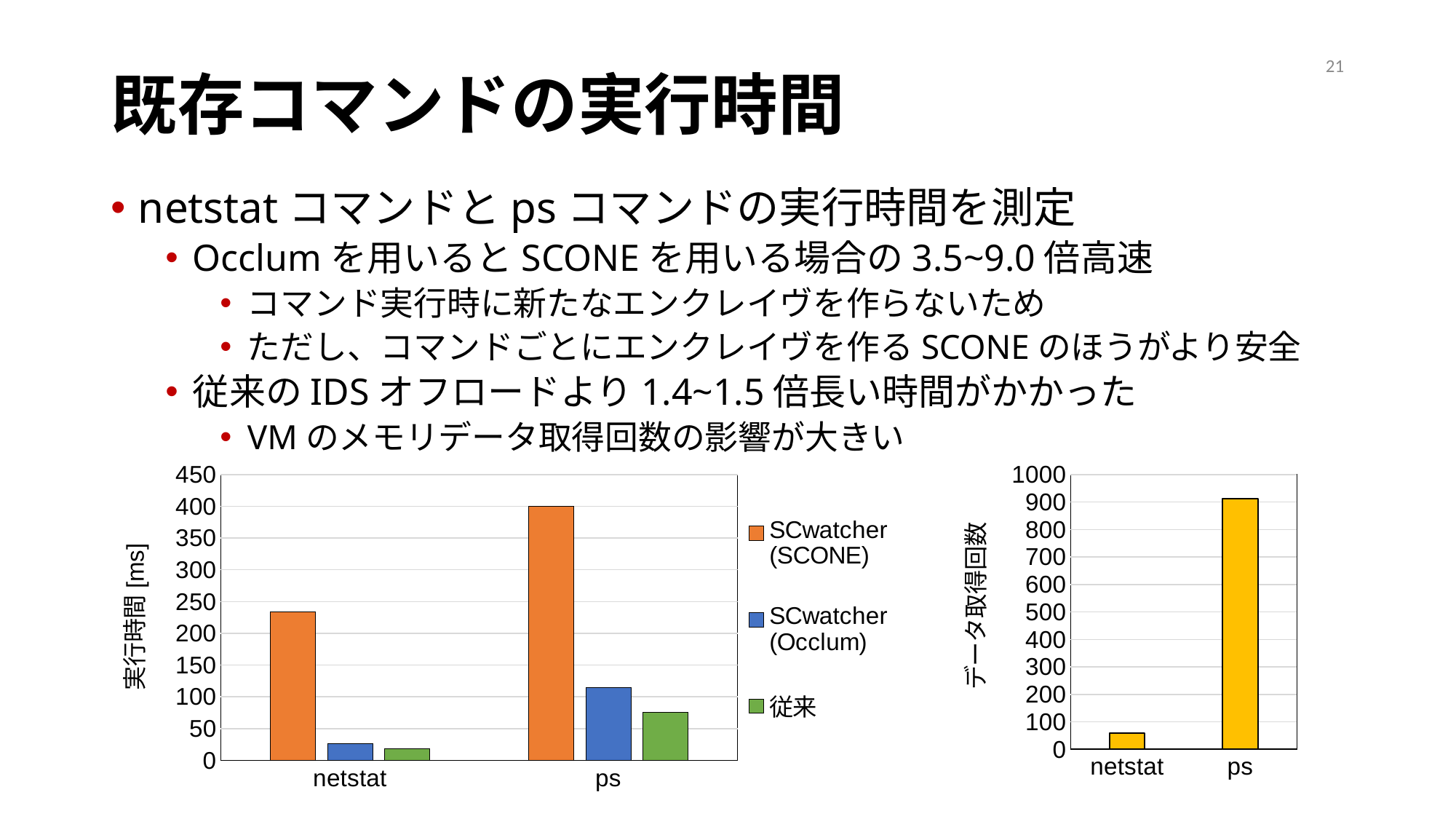
In the left chart (実行時間 [ms]), is the SCwatcher (Occlum) value for ps greater or less than 150? less In the right chart (データ取得回数), which category has the highest value? ps How many series does the legend of the left chart (実行時間 [ms]) list? 3 In the left chart (実行時間 [ms]), which series has the lowest value for netstat? 従来 In the left chart (実行時間 [ms]), does the SCwatcher (SCONE) value rise or fall from netstat to ps? rise In the left chart (実行時間 [ms]), is the SCwatcher (SCONE) value for netstat greater or less than 200? greater How many categories are shown on the x axis of the left chart (実行時間 [ms])? 2 What kind of chart is the left chart showing 実行時間 [ms]? bar chart In the left chart (実行時間 [ms]), which is larger: the SCwatcher (Occlum) value for ps or the 従来 value for ps? SCwatcher (Occlum) In the right chart (データ取得回数), is the value for ps greater or less than 800? greater In the left chart (実行時間 [ms]), which series has the highest value for ps? SCwatcher (SCONE)